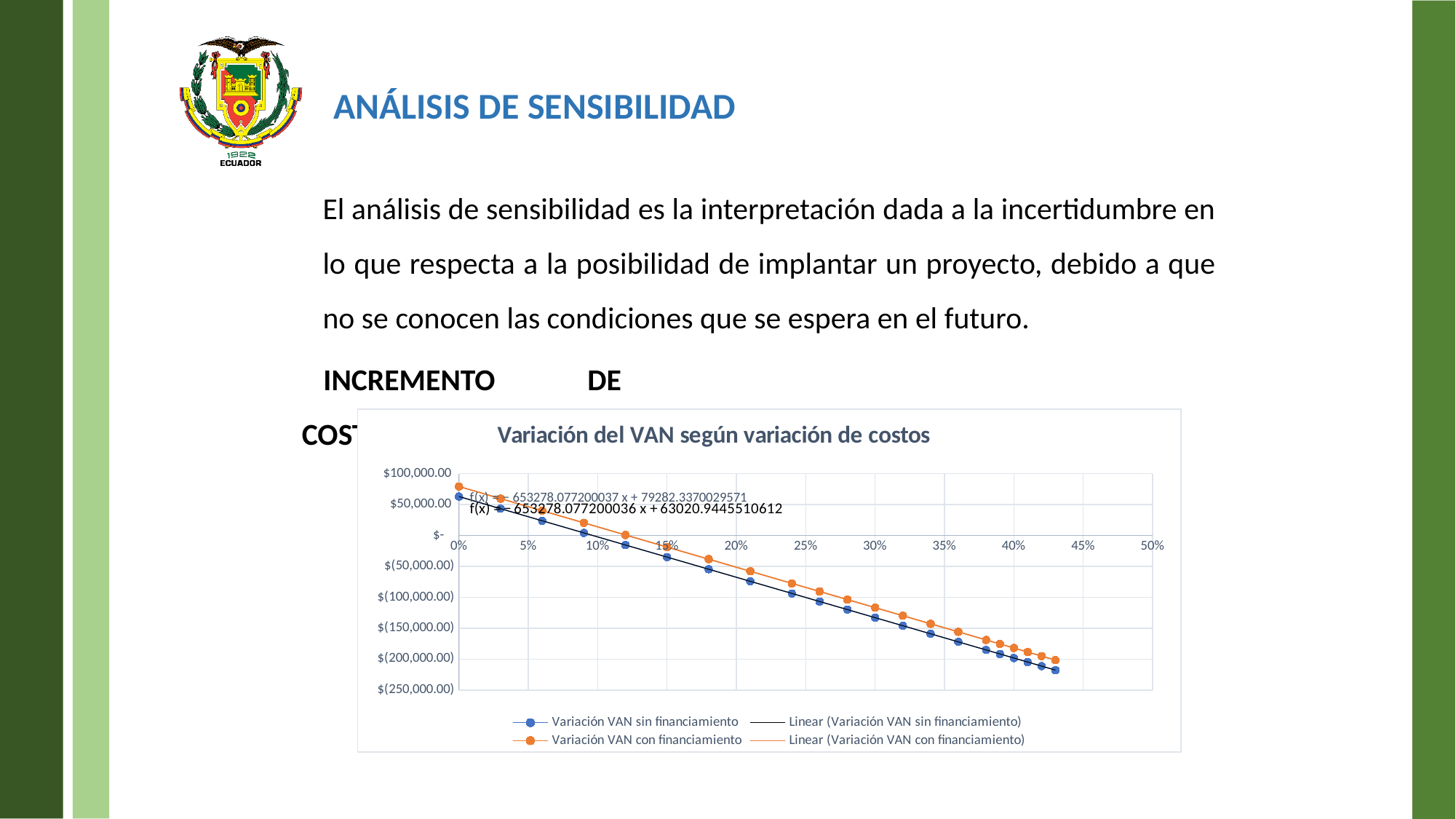
At 0%, is the value for 'Variación VAN con financiamiento' greater or less than $50,000.00? greater What kind of chart is shown on the slide? line chart Do the values of the 'Variación VAN sin financiamiento' series rise or fall as the cost variation increases along the x axis? fall At 0%, is the value for 'Variación VAN sin financiamiento' greater or less than $50,000.00? greater Do the values of the 'Variación VAN con financiamiento' series rise or fall along the x axis? fall At 15%, is the value for 'Variación VAN sin financiamiento' greater or less than $-? less What is the title of the chart? Variación del VAN según variación de costos Which series is plotted in orange? Variación VAN con financiamiento How many entries does the chart legend list? 4 At 20%, which series has the higher value: 'Variación VAN sin financiamiento' or 'Variación VAN con financiamiento'? Variación VAN con financiamiento